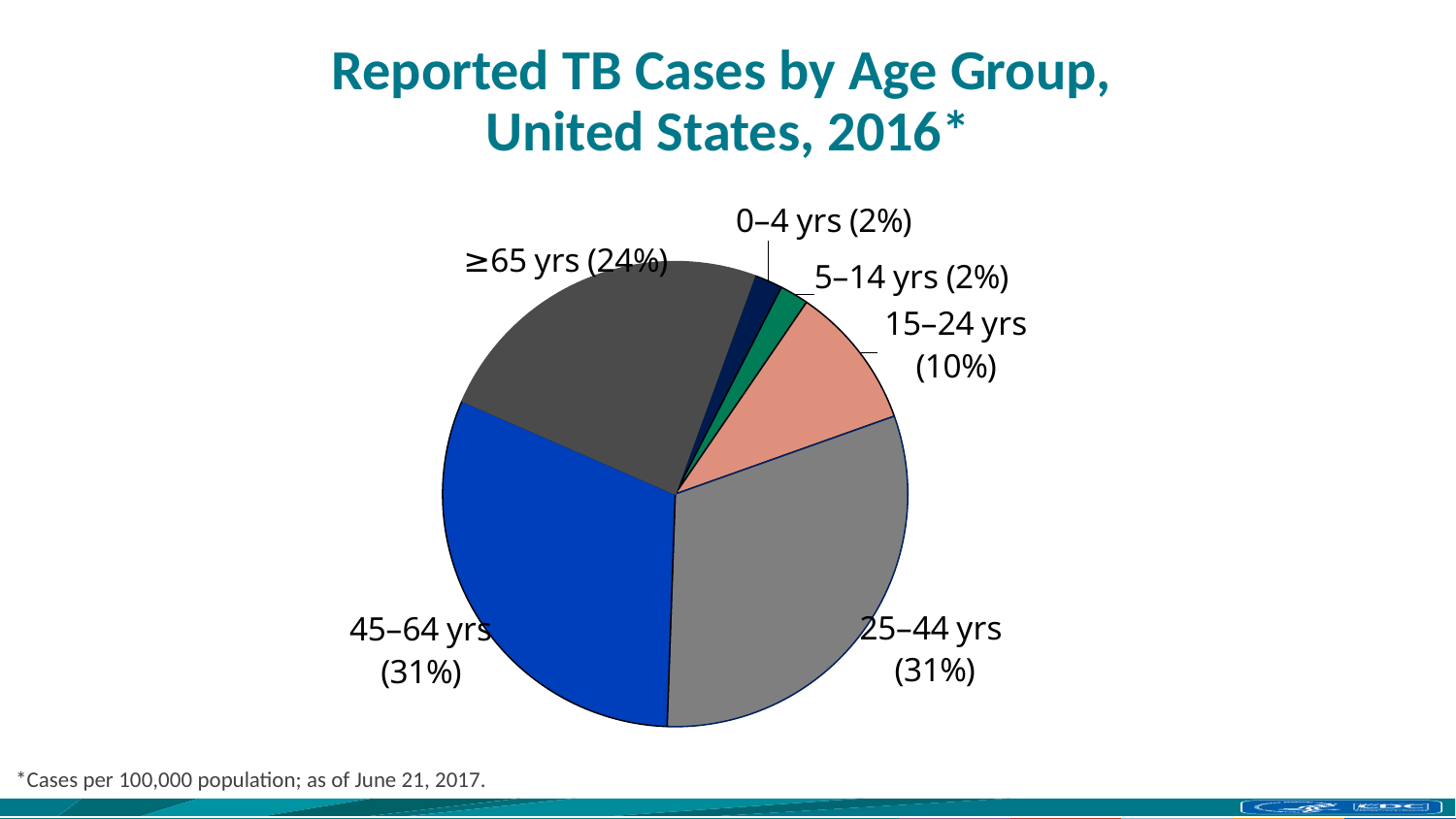
According to the footnote, as of what date are the data reported? June 21, 2017 What is the title of the chart? Reported TB Cases by Age Group, United States, 2016* How many age groups are shown in the pie chart? 6 What percentage of reported TB cases is in the 0–4 yrs age group? 2% What percentage of reported TB cases is in the 15–24 yrs age group? 10% Which two age groups share the largest percentage of reported TB cases? 25–44 yrs and 45–64 yrs What percentage of reported TB cases is in the 45–64 yrs age group? 31% Which age group has a larger share of TB cases, ≥65 yrs or 15–24 yrs? ≥65 yrs What is the difference in percentage points between the 45–64 yrs and 15–24 yrs age groups? 21 percentage points What type of chart is shown on the slide? Pie chart What percentage of reported TB cases is in the ≥65 yrs age group? 24% What is the difference in percentage points between the ≥65 yrs and 15–24 yrs age groups? 14 percentage points